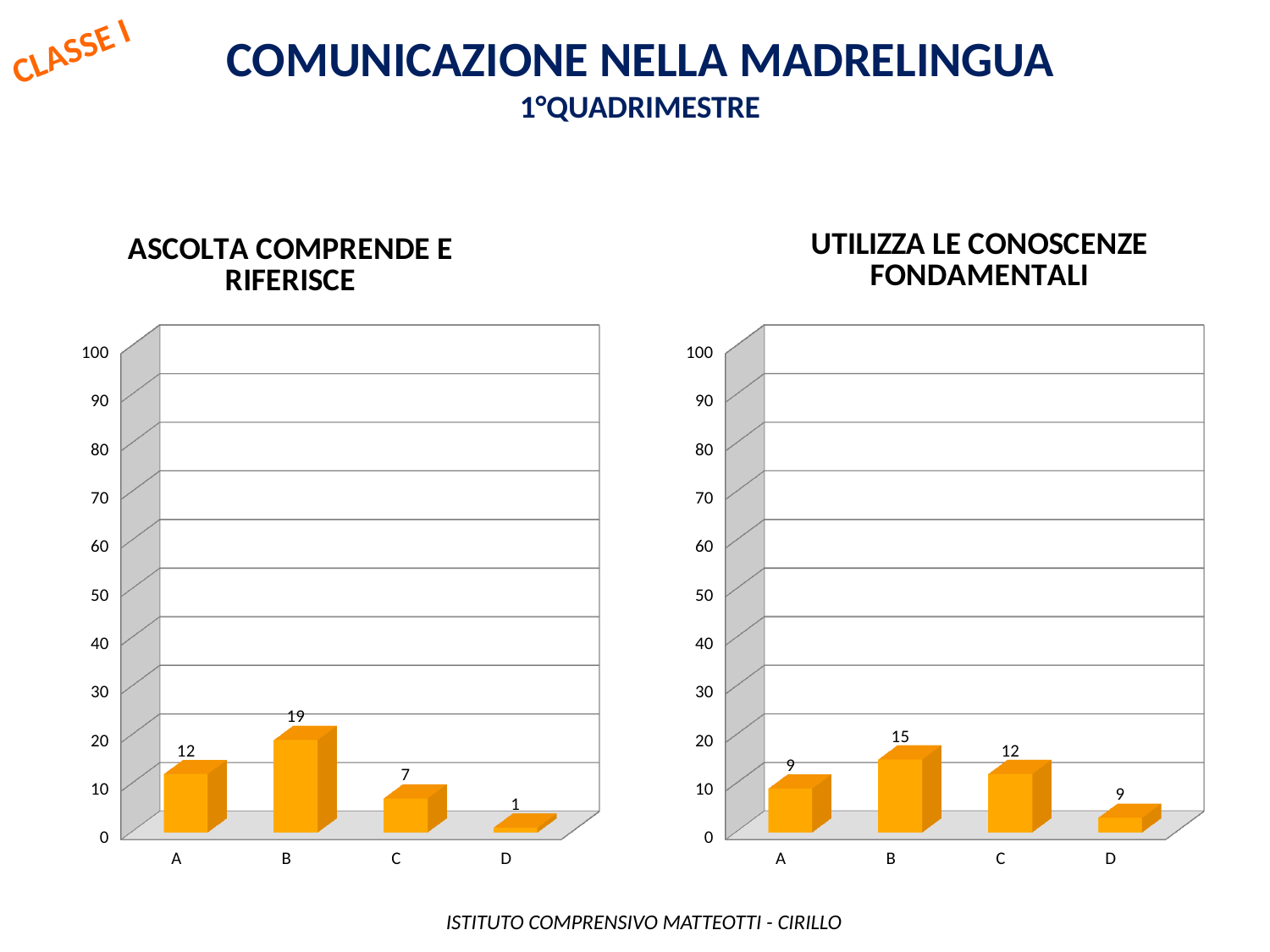
In the chart titled "UTILIZZA LE CONOSCENZE FONDAMENTALI", which is larger, the value for A or the value for C? C In the chart titled "UTILIZZA LE CONOSCENZE FONDAMENTALI", which category has the highest value? B In the chart titled "ASCOLTA COMPRENDE E RIFERISCE", which category has the lowest value? D In the chart titled "ASCOLTA COMPRENDE E RIFERISCE", what is the value for category B? 19 What kind of chart is the chart titled "ASCOLTA COMPRENDE E RIFERISCE"? Bar chart In the chart titled "UTILIZZA LE CONOSCENZE FONDAMENTALI", how many categories are shown on the x axis? 4 In the chart titled "ASCOLTA COMPRENDE E RIFERISCE", what is the value for category D? 1 In the chart titled "ASCOLTA COMPRENDE E RIFERISCE", which category has the highest value? B In the chart titled "ASCOLTA COMPRENDE E RIFERISCE", what is the difference between the values for B and A? 7 In the chart titled "UTILIZZA LE CONOSCENZE FONDAMENTALI", what is the difference between the values for B and D? 6 In the chart titled "UTILIZZA LE CONOSCENZE FONDAMENTALI", what is the value for category C? 12 In the chart titled "ASCOLTA COMPRENDE E RIFERISCE", what is the highest value shown on the vertical axis? 100